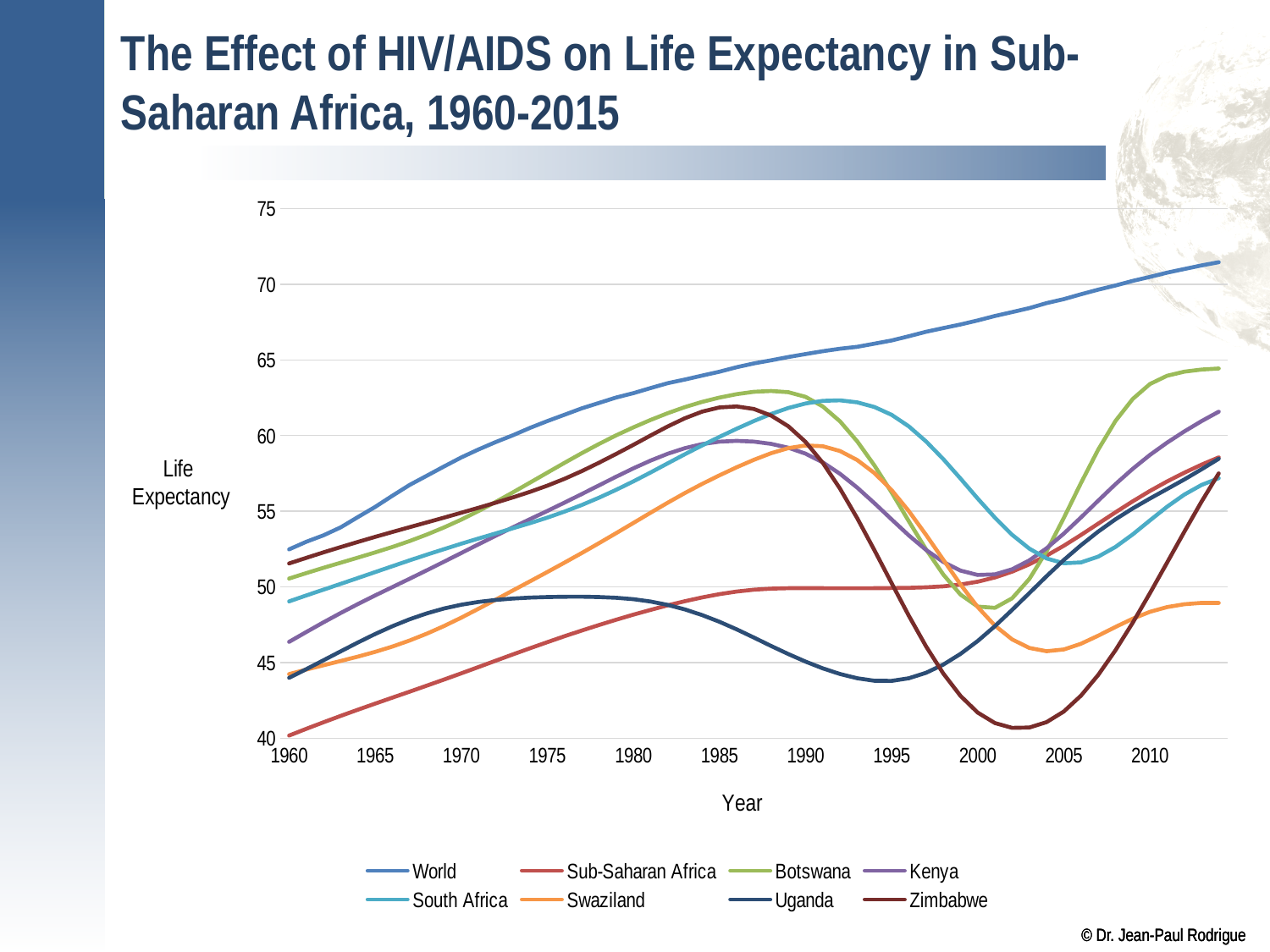
Is the value for Sub-Saharan Africa in 1960 greater or less than 45? less Is the value for Zimbabwe in 1985 greater or less than 60? greater Is the value for Uganda in 1995 greater or less than 45? less What is the label of the vertical axis? Life Expectancy Which series has the lowest life expectancy in 1960? Sub-Saharan Africa What is the title of the chart on the slide? The Effect of HIV/AIDS on Life Expectancy in Sub-Saharan Africa, 1960-2015 Does the World series rise or fall from 1960 to 2015? rise What kind of chart is shown on the slide? line chart In 2015, which is larger: the value for Botswana or the value for Swaziland? Botswana How many series does the legend list? 8 Which series has the highest life expectancy at the right end of the chart (2015)? World Which series has the lowest life expectancy at the right end of the chart (2015)? Swaziland